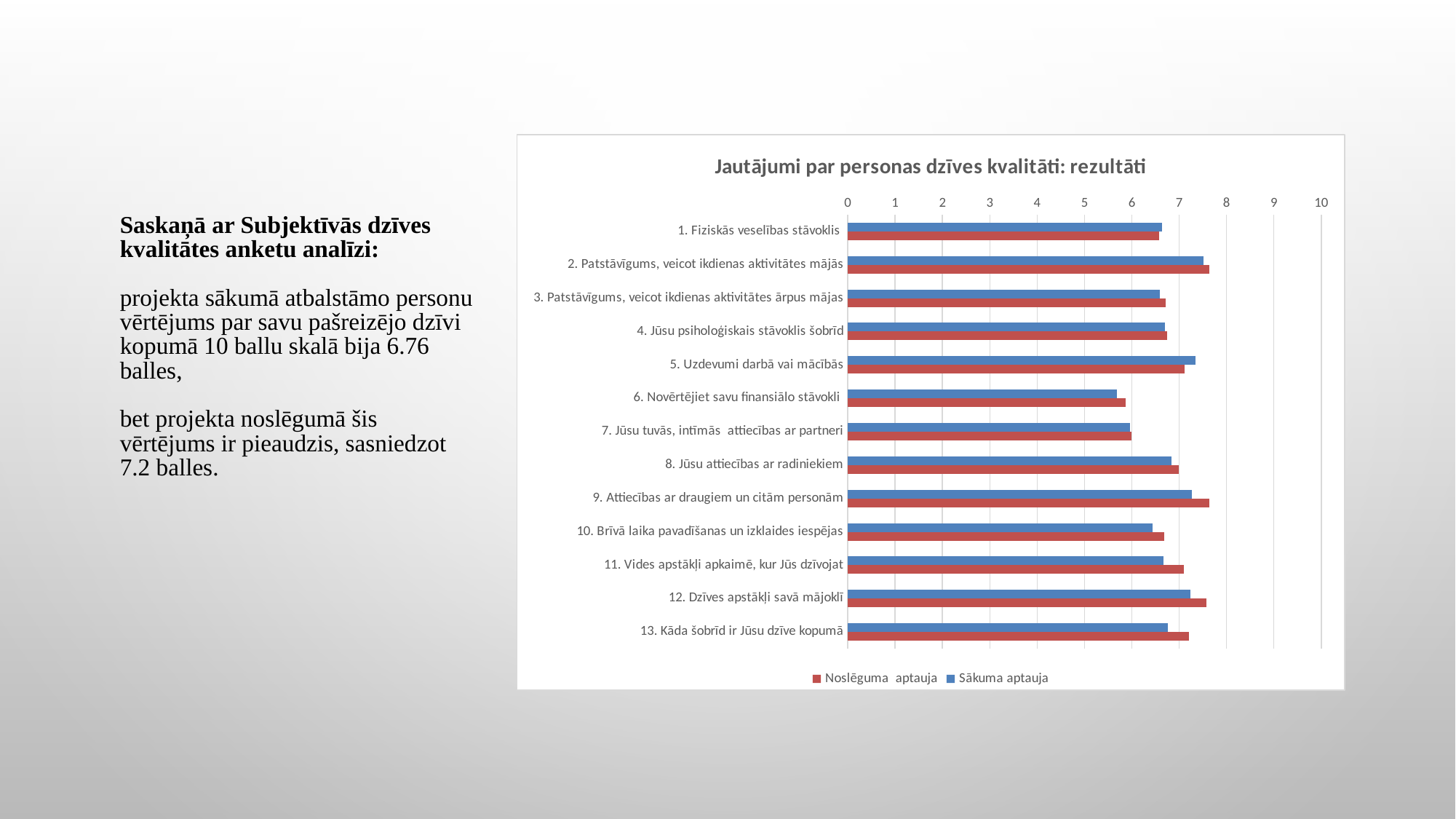
Which category has the lowest value for the Noslēguma aptauja series? 6. Novērtējiet savu finansiālo stāvokli What is the title of the chart? Jautājumi par personas dzīves kvalitāti: rezultāti Is the Sākuma aptauja value for '2. Patstāvīgums, veicot ikdienas aktivitātes mājās' greater or less than 7? greater For '11. Vides apstākļi apkaimē, kur Jūs dzīvojat', which series has the larger value: Noslēguma aptauja or Sākuma aptauja? Noslēguma aptauja Which category has the lowest value for the Sākuma aptauja series? 6. Novērtējiet savu finansiālo stāvokli Is the Noslēguma aptauja value for '6. Novērtējiet savu finansiālo stāvokli' greater or less than 6? less Is the Sākuma aptauja value for '10. Brīvā laika pavadīšanas un izklaides iespējas' greater or less than 7? less How many question categories are plotted on the chart? 13 What kind of chart is shown on the slide? bar chart Which colour represents the Noslēguma aptauja series? red For '13. Kāda šobrīd ir Jūsu dzīve kopumā', which series has the larger value: Noslēguma aptauja or Sākuma aptauja? Noslēguma aptauja How many series does the chart's legend list? 2